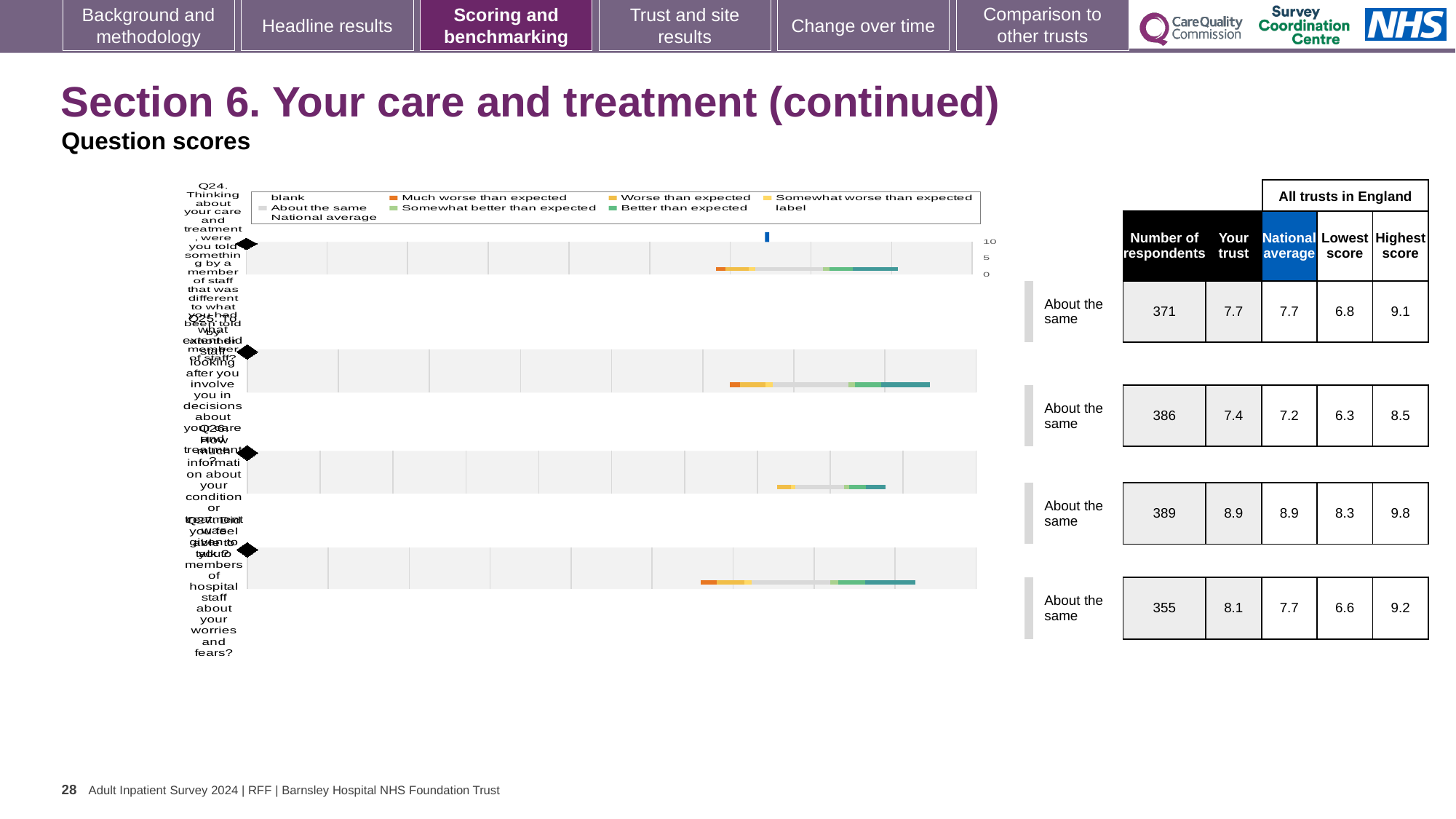
What is the national average for the third row (Q26)? 8.9 What is the number of respondents for the second row (Q25)? 386 Is the 'Your trust' score for the second row (Q25) higher or lower than its national average? higher What is the difference between the 'Your trust' score and the national average for the fourth row (Q27)? 0.4 What kind of chart is used to show the question scores on this slide? bar chart What is the 'Your trust' score for the first row (Q24)? 7.7 What is the highest score across all trusts in England for the fourth row (Q27)? 9.2 How many questions (rows) are plotted in the chart? 4 What is the lowest score across all trusts in England for the first row (Q24)? 6.8 What benchmark category is shown for every row in the chart? About the same Which row has the lowest number of respondents? Q27 (fourth row), 355 Which row has the highest 'Your trust' score? Q26 (third row), 8.9